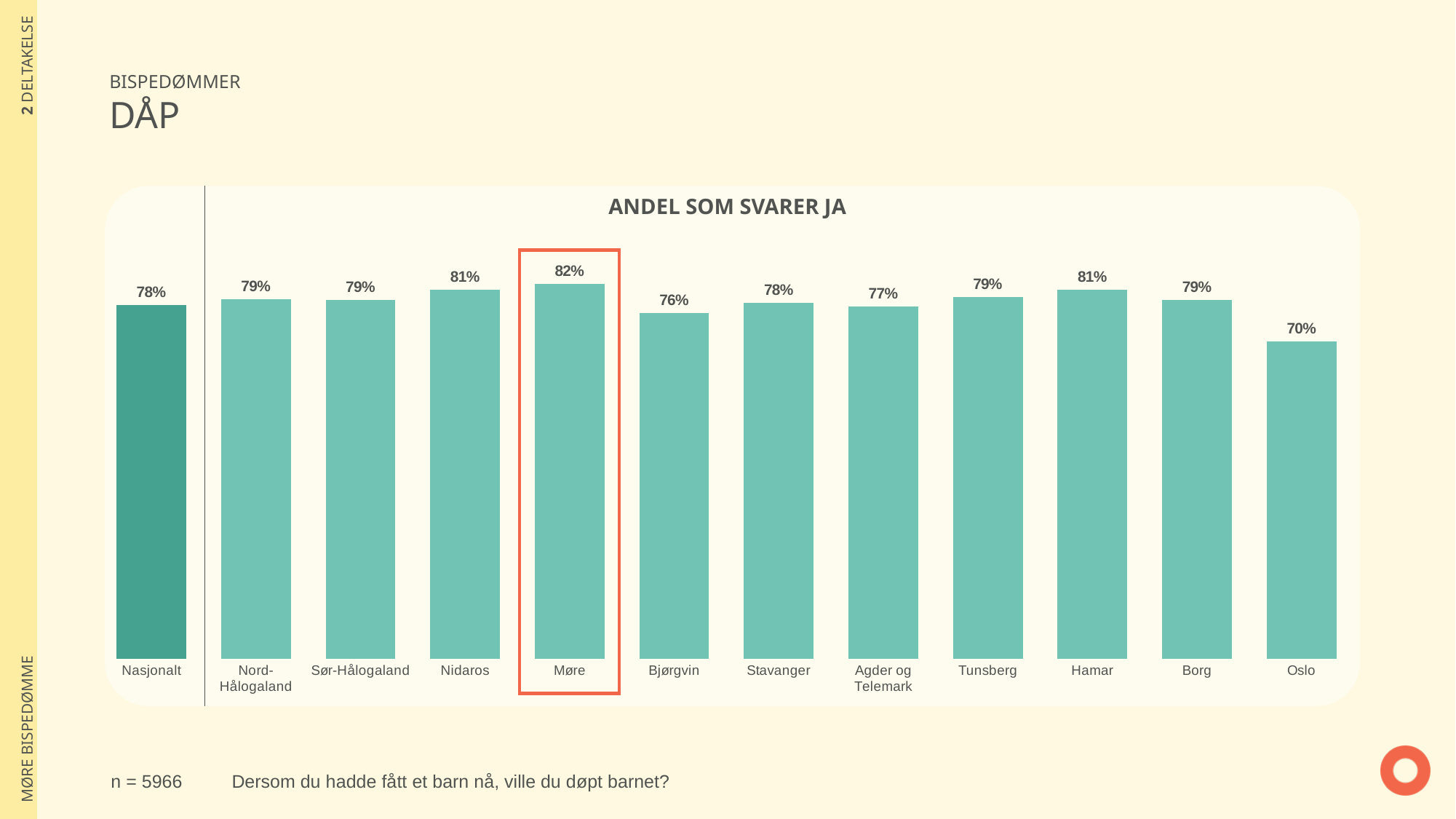
What is the difference between the values for Nidaros and Bjørgvin? 5% What is the value for Nasjonalt? 78% What is the value for Agder og Telemark? 77% What is the difference between the values for Møre and Oslo? 12% What is the value for Møre? 82% Which is larger, the value for Hamar or the value for Stavanger? Hamar Which category has the highest value? Møre What is the value for Oslo? 70% How many categories are shown in the chart? 12 Which category has the lowest value? Oslo What kind of chart is shown on the slide? Bar chart What is the title of the chart? ANDEL SOM SVARER JA